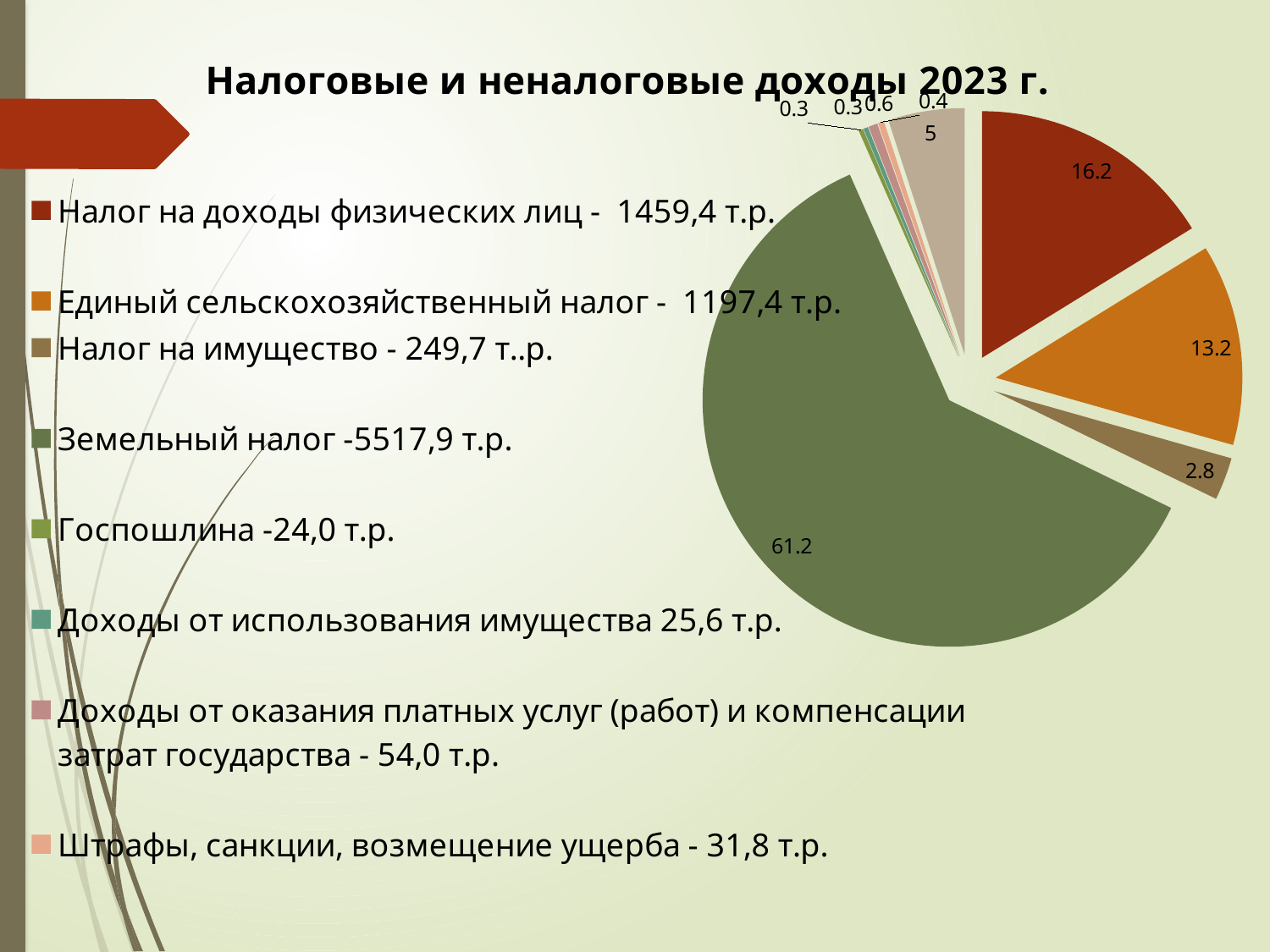
What is the title of the chart? Налоговые и неналоговые доходы 2023 г. What value is labelled on the slice for Земельный налог? 61.2 How many slices does the pie chart have? 9 What kind of chart is shown on the slide? pie chart Which category has the largest slice of the pie? Земельный налог What value is labelled on the slice for Налог на имущество? 2.8 According to the legend, what amount is given for Земельный налог? 5517,9 т.р. Which slice is larger: Налог на доходы физических лиц or Единый сельскохозяйственный налог? Налог на доходы физических лиц What is the difference between the labelled values for Налог на доходы физических лиц and Единый сельскохозяйственный налог? 3 What value is labelled on the slice for Налог на доходы физических лиц? 16.2 What value is labelled on the slice for Единый сельскохозяйственный налог? 13.2 What is the difference between the labelled values for Земельный налог and Налог на доходы физических лиц? 45